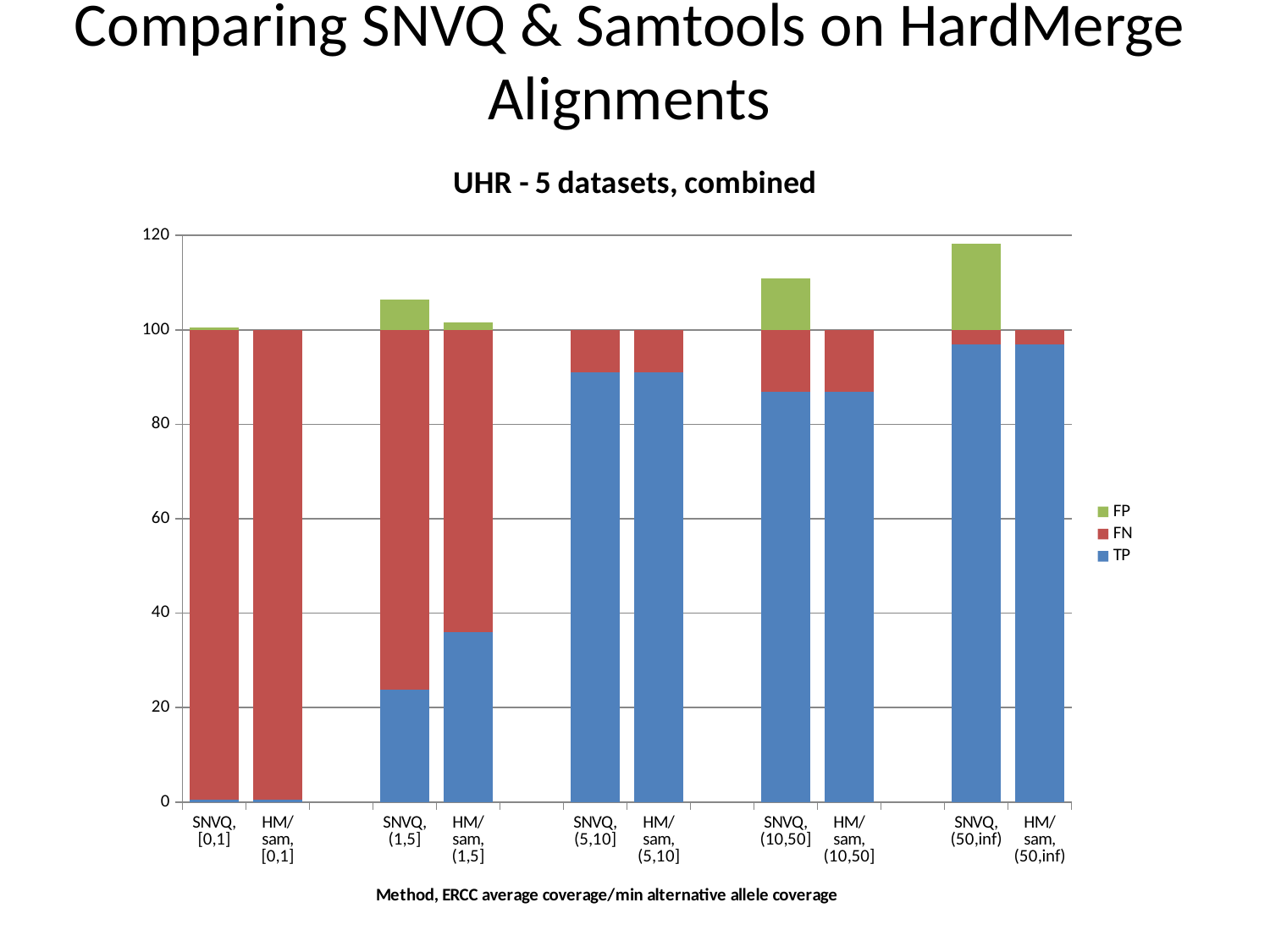
Which has the larger TP value: SNVQ, (1,5] or HM/sam, (1,5]? HM/sam, (1,5] Which bar is taller in total: SNVQ, (10,50] or HM/sam, (10,50]? SNVQ, (10,50] How many series does the legend list? 3 Is the total height of the SNVQ, (10,50] bar greater or less than 100? greater Does the TP portion of the bars generally rise or fall moving from left to right along the x axis? rise Is the TP value for HM/sam, (1,5] greater or less than 40? less Which bar reaches the greatest total height? SNVQ, (50,inf) Is the TP value for SNVQ, (5,10] greater or less than 80? greater How many bars are plotted in the chart? 10 Which series is shown in green in the legend? FP What is the title of the chart? UHR - 5 datasets, combined What kind of chart is shown on the slide? stacked bar chart